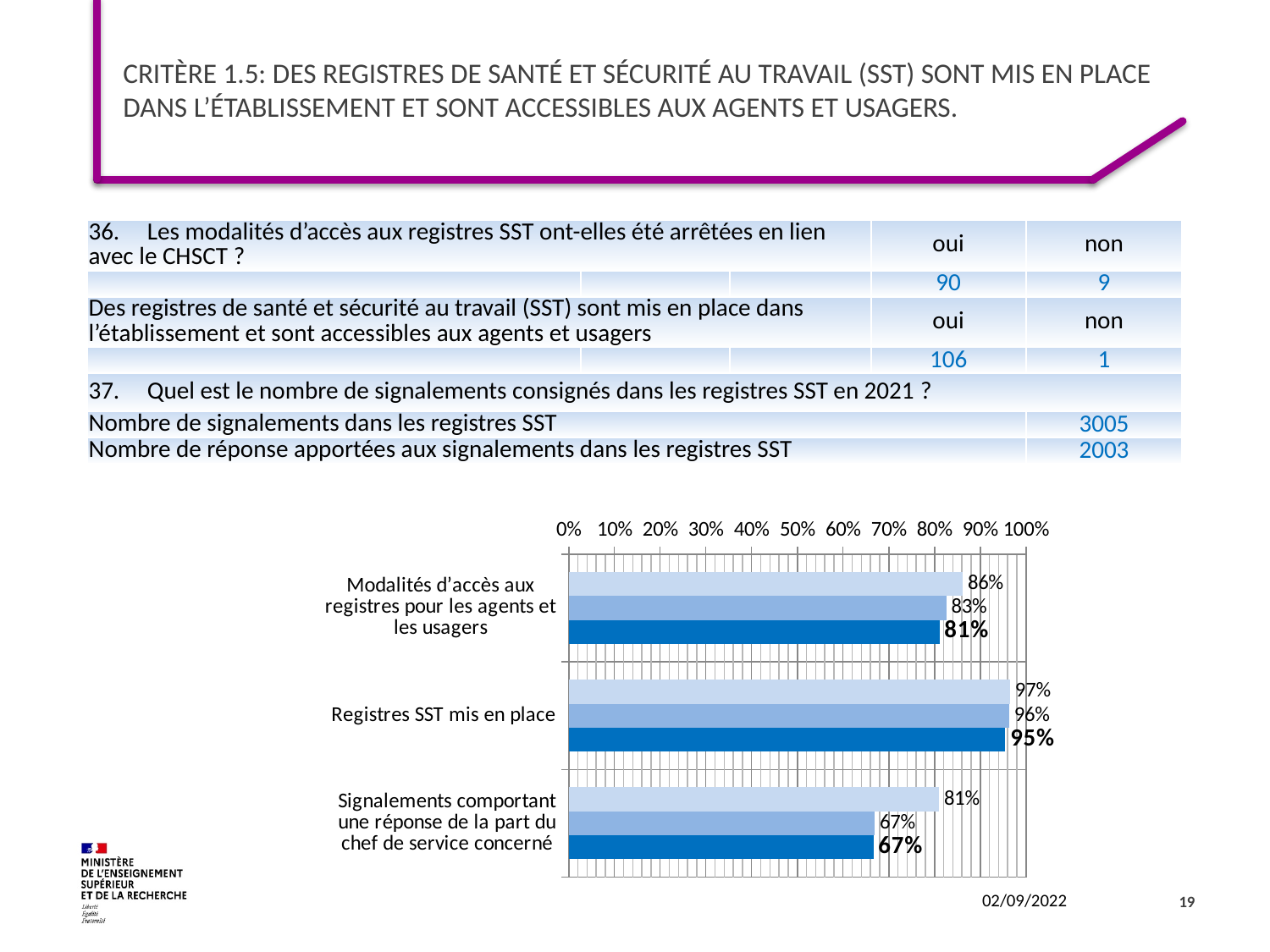
Which is larger: the darkest (bottom) bar for 'Registres SST mis en place' or the darkest (bottom) bar for 'Modalités d'accès aux registres pour les agents et les usagers'? Registres SST mis en place How many bars are drawn for each category on the chart? 3 What is the value of the darkest (bottom) bar for 'Registres SST mis en place'? 95% Which category has the lowest value for the lightest (top) bar? Signalements comportant une réponse de la part du chef de service concerné What is the value of the lightest (top) bar for 'Registres SST mis en place'? 97% How many categories are shown on the chart's vertical axis? 3 What is the difference between the lightest (top) bar and the darkest (bottom) bar for 'Signalements comportant une réponse de la part du chef de service concerné'? 14% What is the value of the lightest (top) bar for 'Signalements comportant une réponse de la part du chef de service concerné'? 81% Which category has the highest value for the darkest (bottom) bar? Registres SST mis en place What is the value of the middle bar for 'Signalements comportant une réponse de la part du chef de service concerné'? 67% What is the value of the darkest (bottom) bar for 'Modalités d'accès aux registres pour les agents et les usagers'? 81% What kind of chart is shown on the slide? bar chart